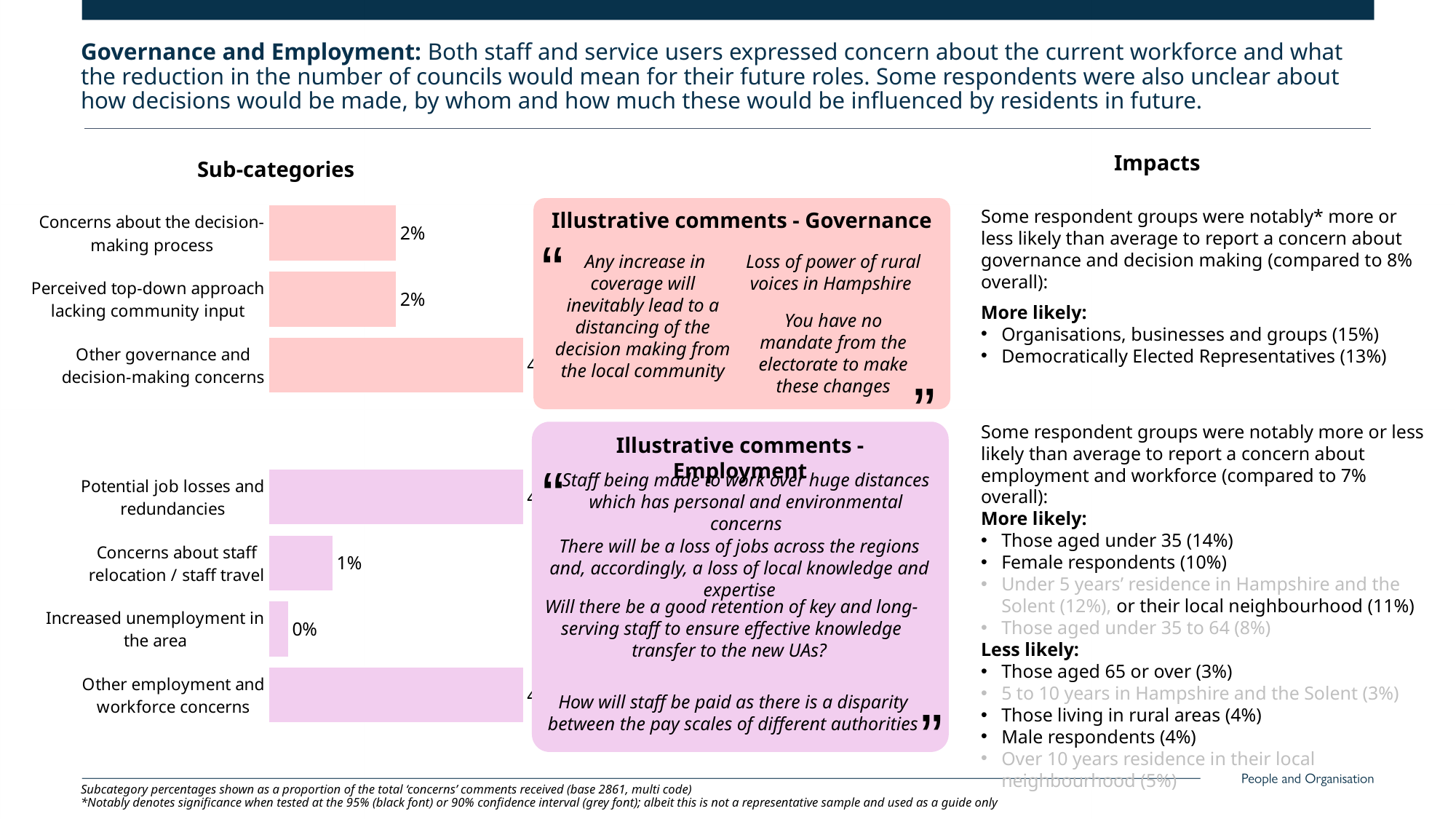
In the top (governance) bar chart, what is the value for 'Perceived top-down approach lacking community input'? 2% How many categories are shown in the bottom (employment) bar chart? 4 In the bottom (employment) bar chart, what is the difference between 'Concerns about staff relocation / staff travel' and 'Increased unemployment in the area'? 1% In the bottom (employment) bar chart, which is larger: 'Potential job losses and redundancies' or 'Concerns about staff relocation / staff travel'? Potential job losses and redundancies What type of chart is used to show the sub-categories on this slide? Bar chart In the bottom (employment) bar chart, which is larger: 'Concerns about staff relocation / staff travel' or 'Increased unemployment in the area'? Concerns about staff relocation / staff travel In the bottom (employment) bar chart, which category has the lowest value? Increased unemployment in the area In the bottom (employment) bar chart, what is the value for 'Concerns about staff relocation / staff travel'? 1% In the bottom (employment) bar chart, what is the value for 'Increased unemployment in the area'? 0% How many categories are shown in the top (governance) bar chart? 3 In the top (governance) bar chart, what is the value for 'Concerns about the decision-making process'? 2% In the top (governance) bar chart, which category has the longest bar? Other governance and decision-making concerns